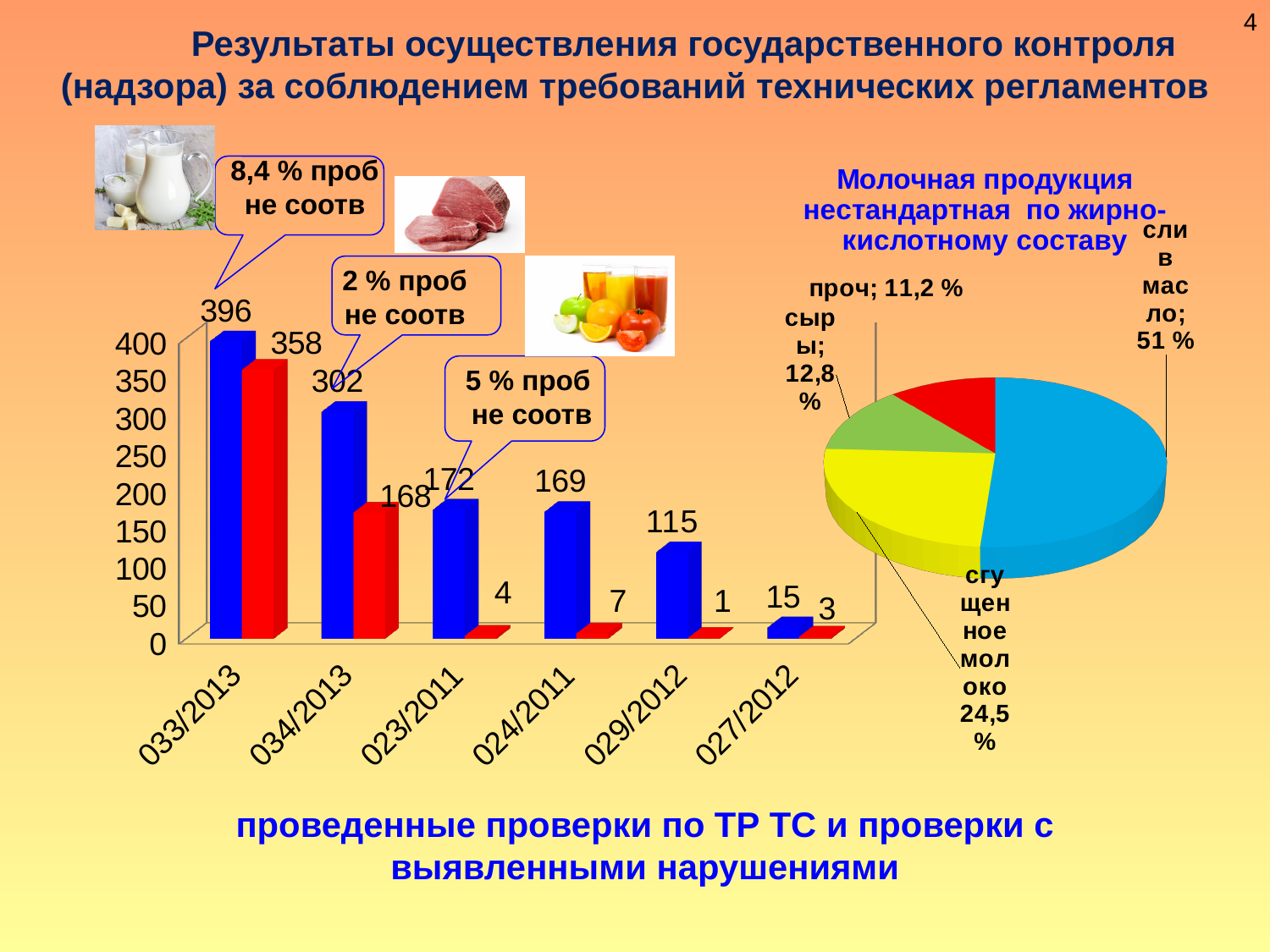
What type of chart is the chart on the left of the slide? bar chart On the bar chart on the left, which category has the lowest blue bar? 027/2012 On the bar chart on the left, what is the difference between the blue and red bars for 033/2013? 38 On the bar chart on the left, which is larger: the blue bar for 023/2011 or the blue bar for 024/2011? 023/2011 In the pie chart 'Молочная продукция нестандартная по жирно-кислотному составу', what share does сливочное масло have? 51 % On the bar chart on the left, what is the value of the red bar for 029/2012? 1 On the bar chart on the left, what is the value of the blue bar for 033/2013? 396 How many categories are shown on the x axis of the bar chart on the left? 6 On the bar chart on the left, what is the value of the red bar for 034/2013? 168 In the pie chart 'Молочная продукция нестандартная по жирно-кислотному составу', which slice is the smallest? проч In the pie chart 'Молочная продукция нестандартная по жирно-кислотному составу', what share does сгущенное молоко have? 24,5 % On the bar chart on the left, which category has the highest blue bar? 033/2013